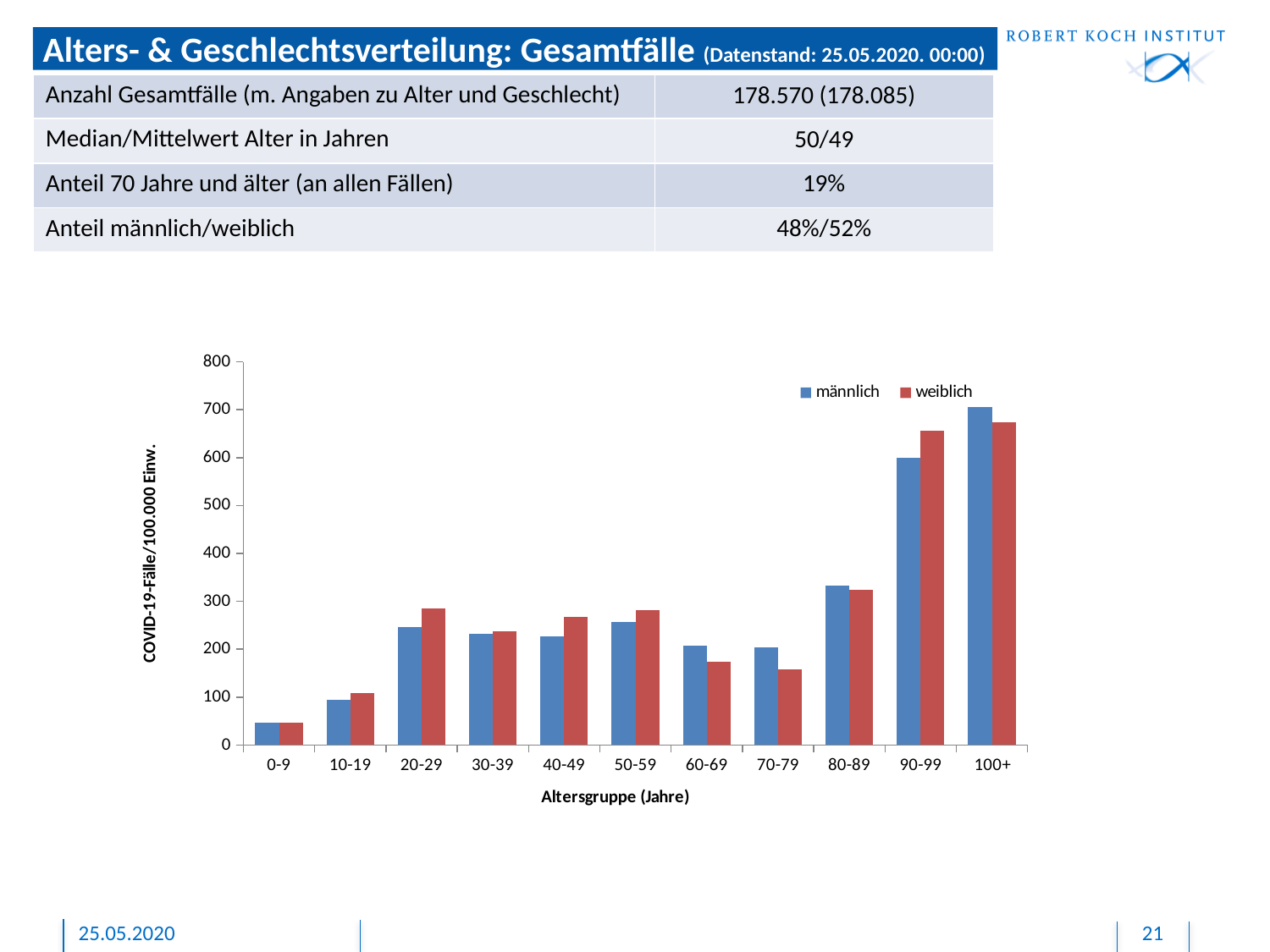
What is the label of the chart's y axis? COVID-19-Fälle/100.000 Einw. Is the weiblich value for the 20-29 age group greater or less than 200? greater How many age groups are shown on the x axis of the chart? 11 Which age group has the highest value for männlich? 100+ Which age group has the lowest value for männlich? 0-9 Is the männlich value for the 90-99 age group greater or less than 500? greater How many series does the chart's legend list? 2 Is the weiblich value for the 70-79 age group greater or less than 200? less In the 60-69 age group, which series has the larger value, männlich or weiblich? männlich Which age group has the highest value for weiblich? 100+ What kind of chart is shown on the slide? bar chart In the 90-99 age group, which series has the larger value, männlich or weiblich? weiblich